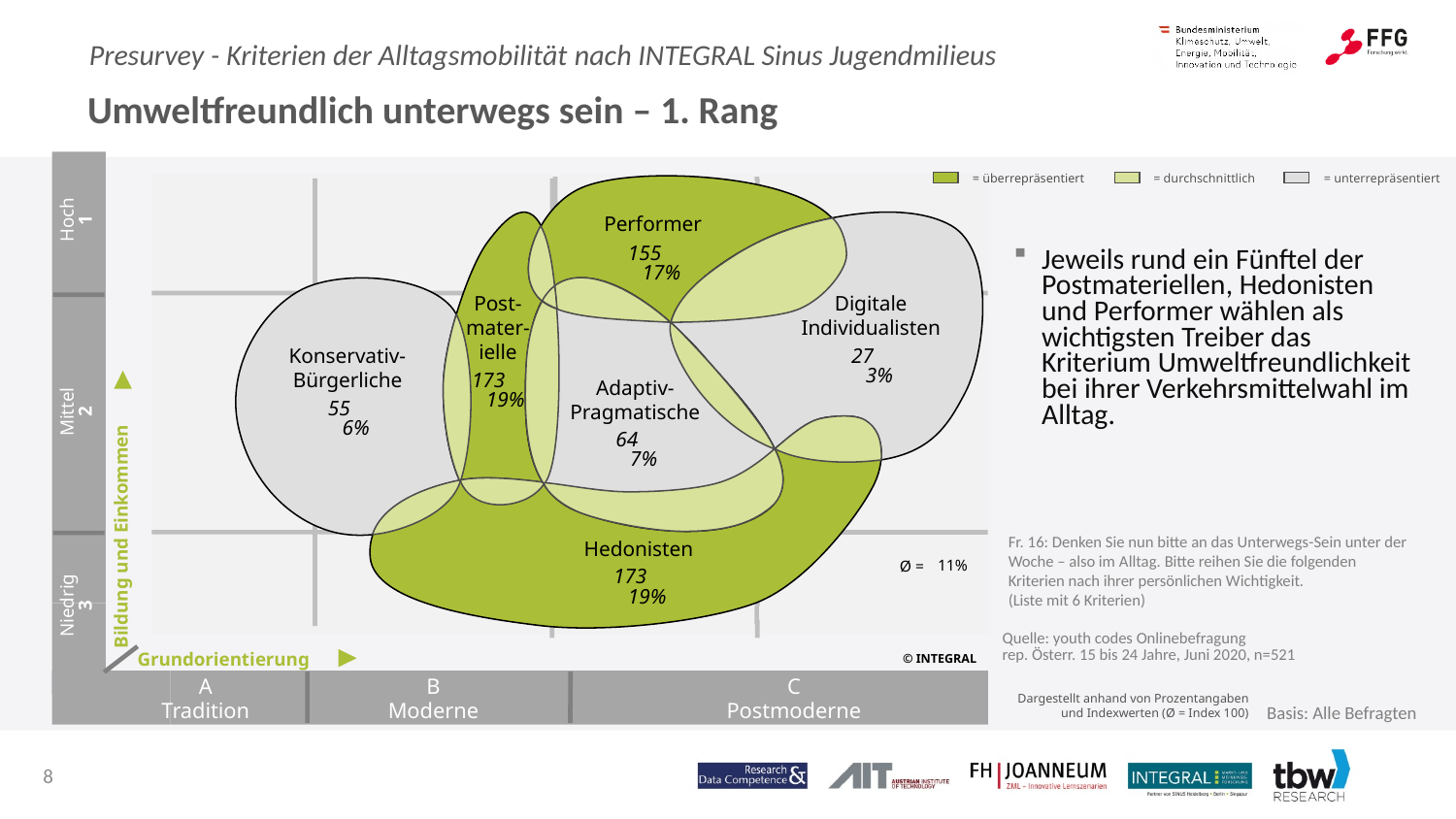
What index value is shown for the Performer milieu? 155 What index value is shown for the Adaptiv-Pragmatische milieu? 64 What average (Ø) percentage is shown on the map? 11% How many milieus are labelled with values on the map? 6 How many categories does the colour legend above the map list? 3 What percentage is shown for the Hedonisten milieu? 19% Which milieu has the lowest percentage shown on the map? Digitale Individualisten What index value is shown for the Digitale Individualisten milieu? 27 What is the difference between the index values of Performer and Digitale Individualisten? 128 Which has the higher index value, Performer or Konservativ-Bürgerliche? Performer What is the difference in percentage between Postmaterielle and Adaptiv-Pragmatische? 12% What percentage is shown for the Konservativ-Bürgerliche milieu? 6%